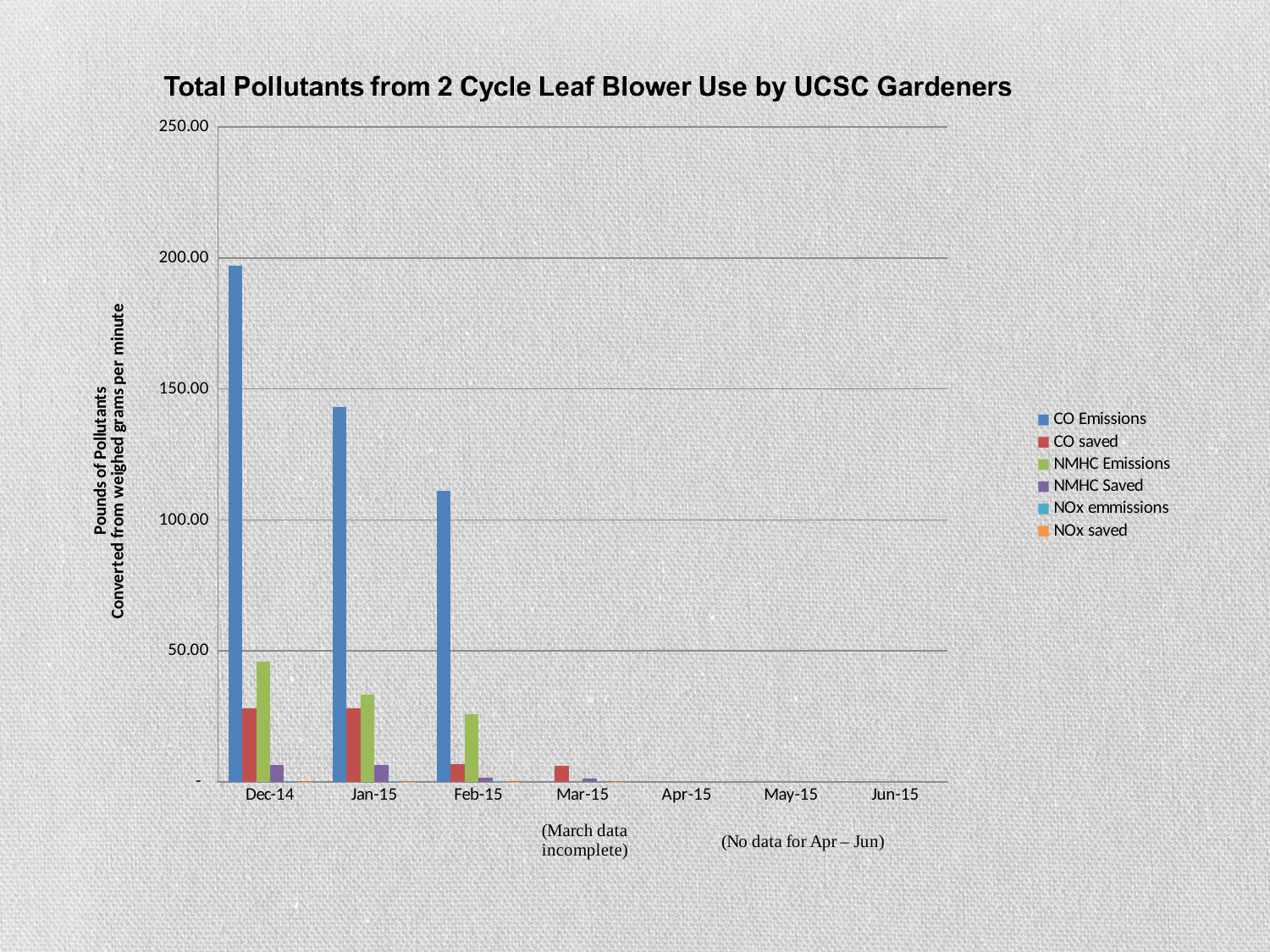
Is the CO Emissions value for Jan-15 greater or less than 200? less Do the CO Emissions values rise or fall from Dec-14 to Feb-15? fall What is the label of the y axis? Pounds of Pollutants Converted from weighed grams per minute Is the CO Emissions value for Dec-14 greater or less than 150? greater In Dec-14, which is larger, NMHC Emissions or CO saved? NMHC Emissions How many series does the legend list? 6 Which is larger, the CO Emissions value for Dec-14 or for Jan-15? Dec-14 Is the CO Emissions value for Feb-15 greater or less than 100? greater In which month is the CO Emissions value highest? Dec-14 What is the title of the chart? Total Pollutants from 2 Cycle Leaf Blower Use by UCSC Gardeners What kind of chart is shown on the slide? bar chart How many month categories are shown on the x axis? 7